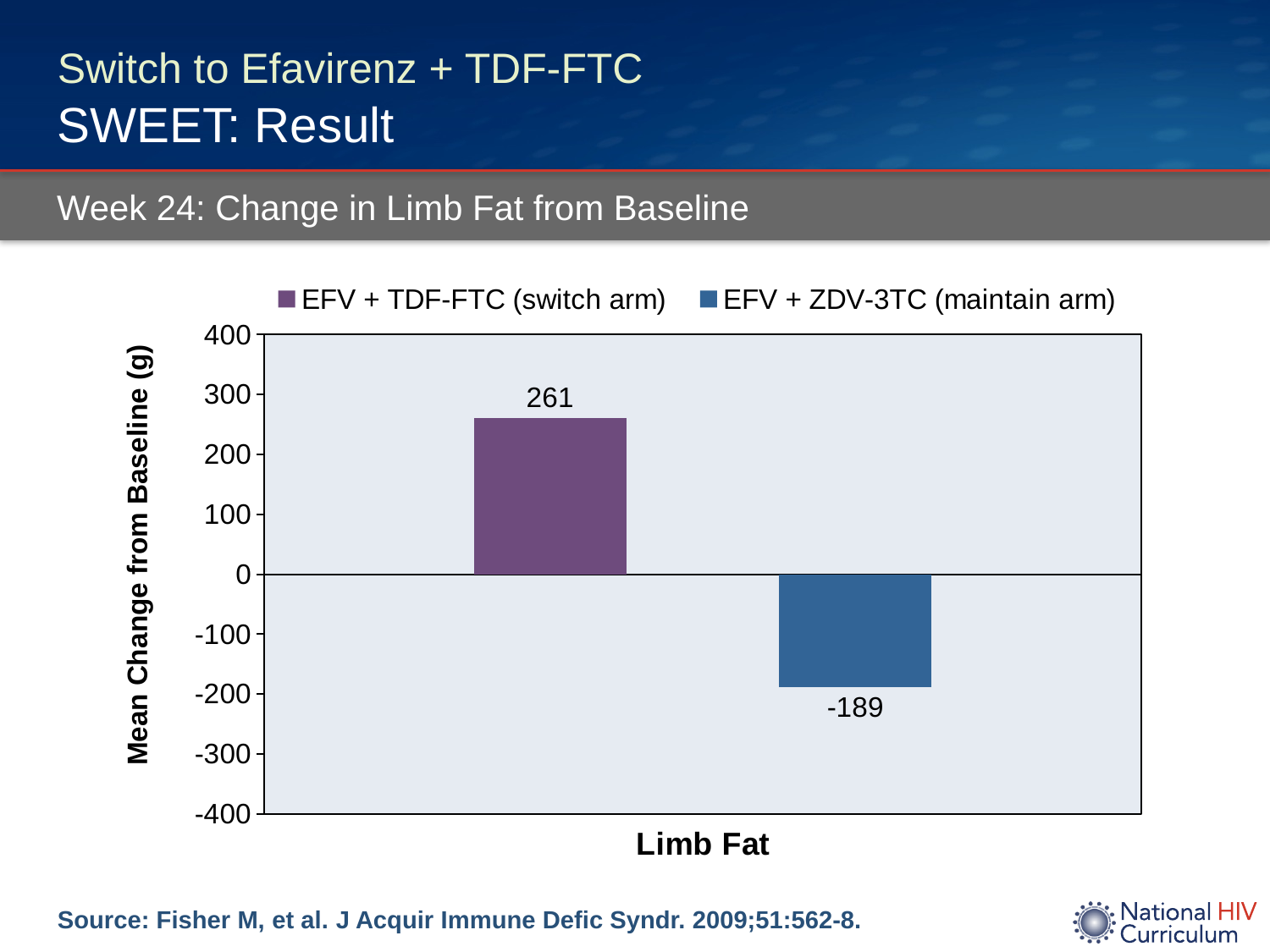
Is the mean change in limb fat for the maintain arm positive or negative? negative What kind of chart is shown on the slide? Bar chart Is the value for the EFV + ZDV-3TC (maintain arm) greater or less than -100? less Which arm has the higher mean change in limb fat from baseline? EFV + TDF-FTC (switch arm) How many series does the legend list? 2 What is the mean change in limb fat from baseline for the EFV + TDF-FTC (switch arm)? 261 What is the label on the y axis of the chart? Mean Change from Baseline (g) Which arm has the lower mean change in limb fat from baseline? EFV + ZDV-3TC (maintain arm) What is the difference between the mean change in limb fat for the switch arm and the maintain arm? 450 Is the value for the EFV + TDF-FTC (switch arm) greater or less than 200? greater What is the label on the x axis of the chart? Limb Fat What is the mean change in limb fat from baseline for the EFV + ZDV-3TC (maintain arm)? -189